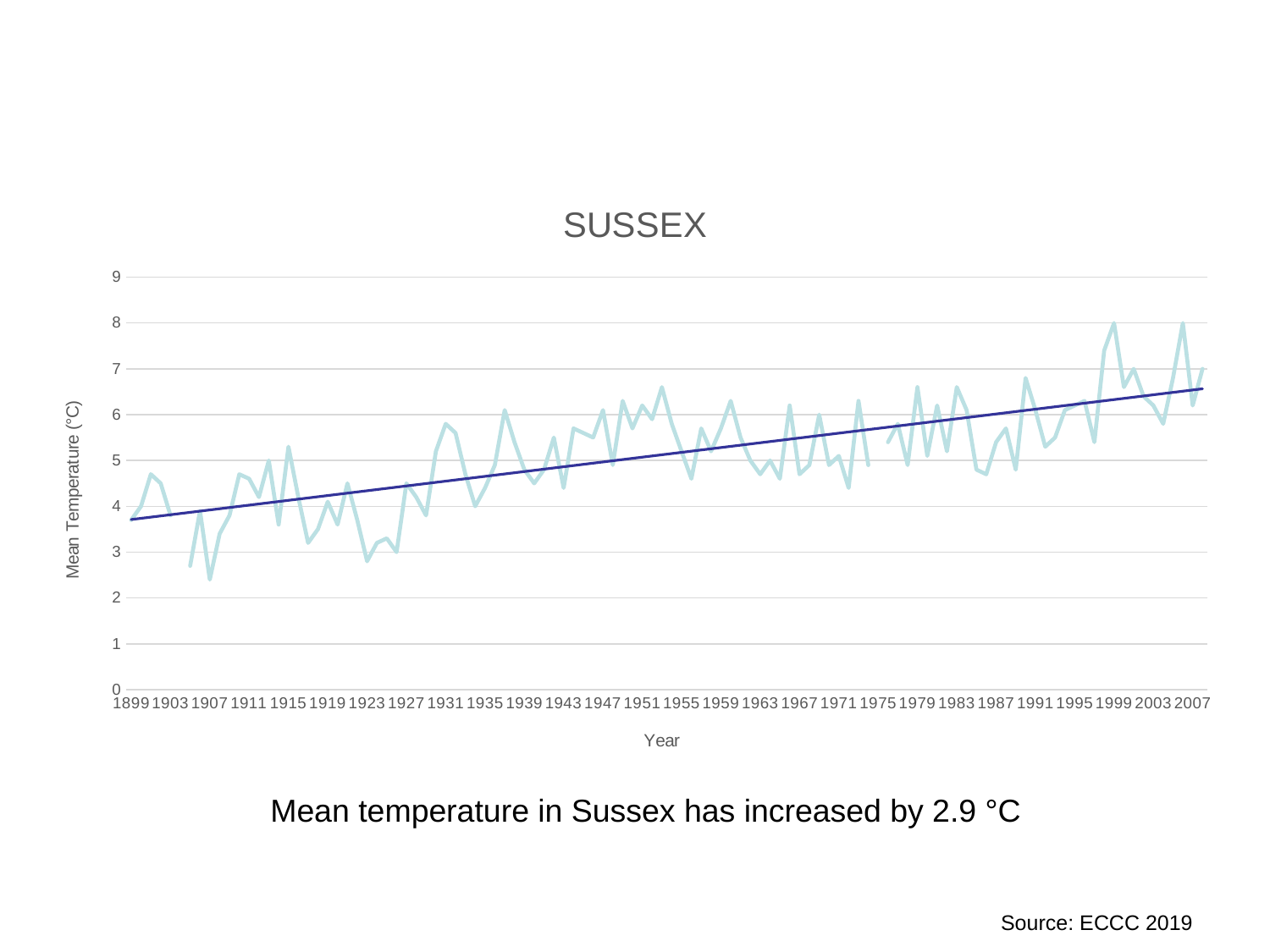
Is the mean temperature value for 1899 greater or less than 5? less Is the mean temperature value for 1931 greater or less than 5? greater What is the label on the vertical axis of the chart? Mean Temperature (°C) Is the mean temperature value for 2007 greater or less than 6? greater What kind of chart is shown on the slide? Line chart What is the title of the chart? SUSSEX Does the trend line for mean temperature rise or fall from 1899 to 2007? Rise